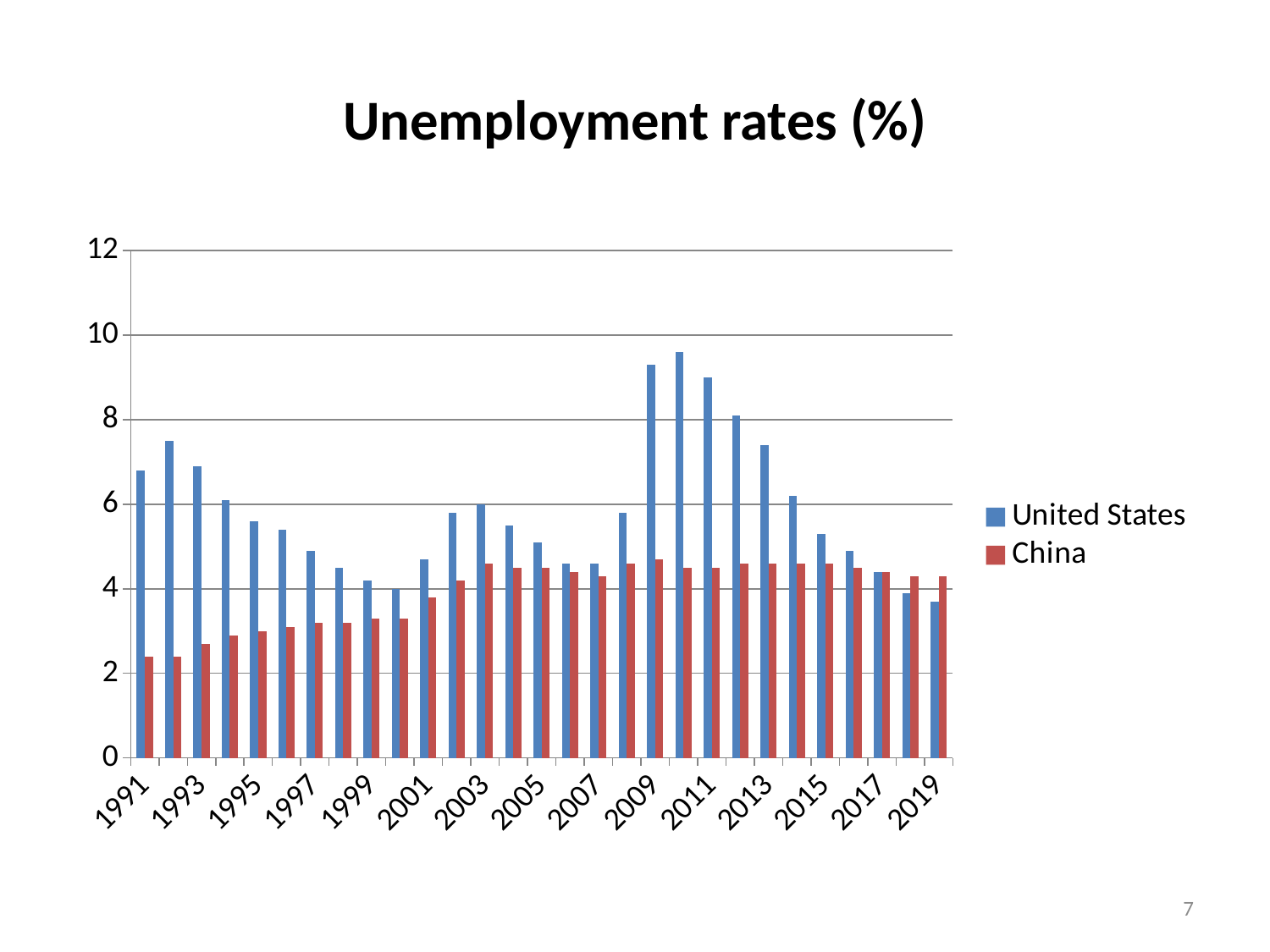
In 1991, which is larger: the United States value or the China value? United States Is the China value for 1991 greater or less than 4? less Is the United States value for 1991 greater or less than 6? greater Does the United States unemployment rate rise or fall from 2010 to 2019? fall What kind of chart is shown on the slide? bar chart In which year is the United States unemployment rate highest? 2010 Is the United States value for 2019 greater or less than 4? less In 2019, which is larger: the United States value or the China value? China How many series does the legend list? 2 What is the title of the chart? Unemployment rates (%) Which series is shown in red? China